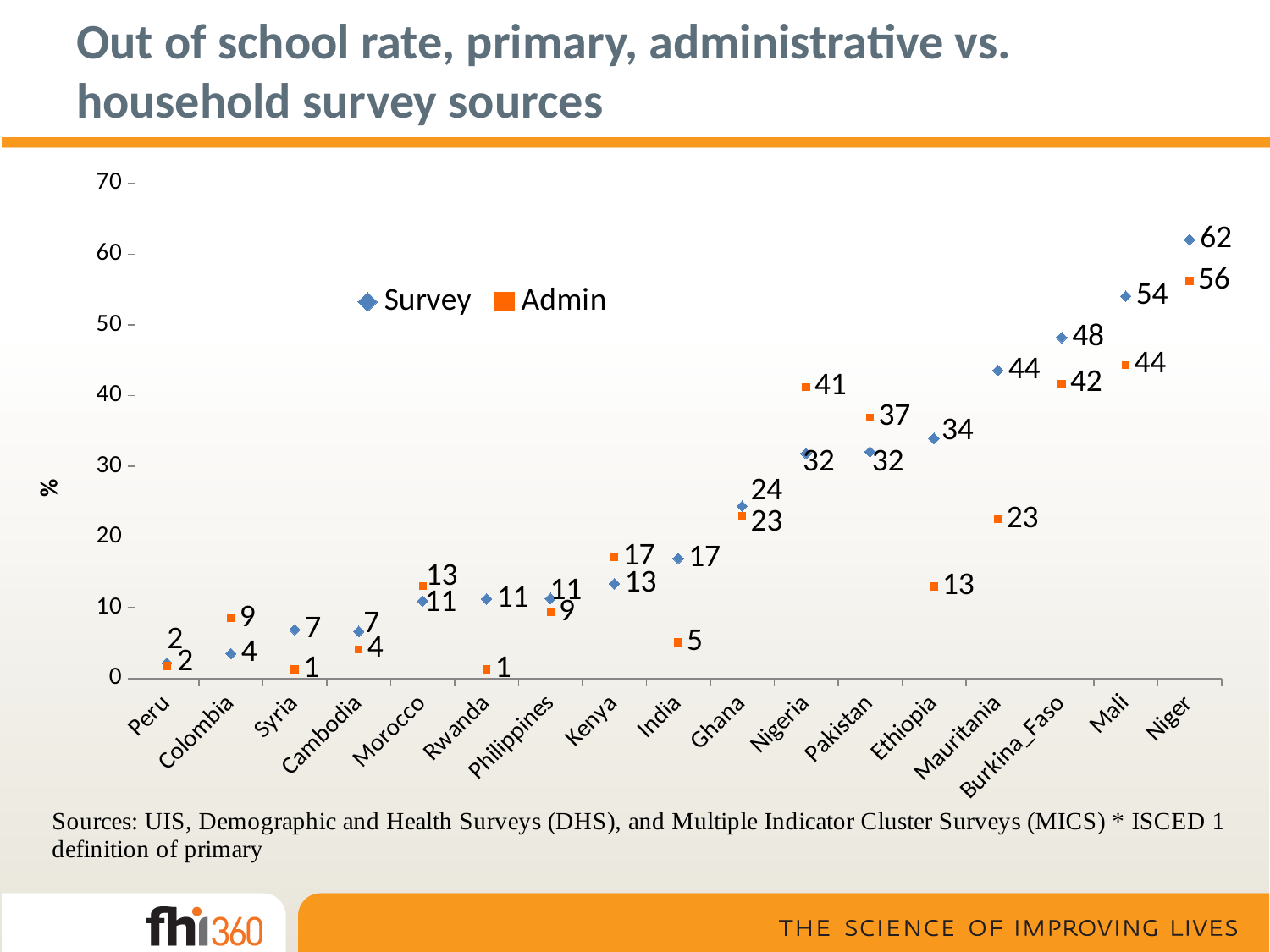
What is the difference between the Survey and Admin values for Mauritania? 21 For India, which is larger, the Survey value or the Admin value? Survey For Nigeria, which is larger, the Survey value or the Admin value? Admin What is the Survey value for Niger? 62 Which country has the highest Survey value? Niger Do the Survey values generally rise or fall from Peru to Niger along the x axis? rise How many countries are shown on the x axis? 17 What is the Admin value for Nigeria? 41 Which country has the lowest Survey value? Peru What is the Admin value for Ethiopia? 13 What is the label on the vertical axis? % How many series does the legend list? 2